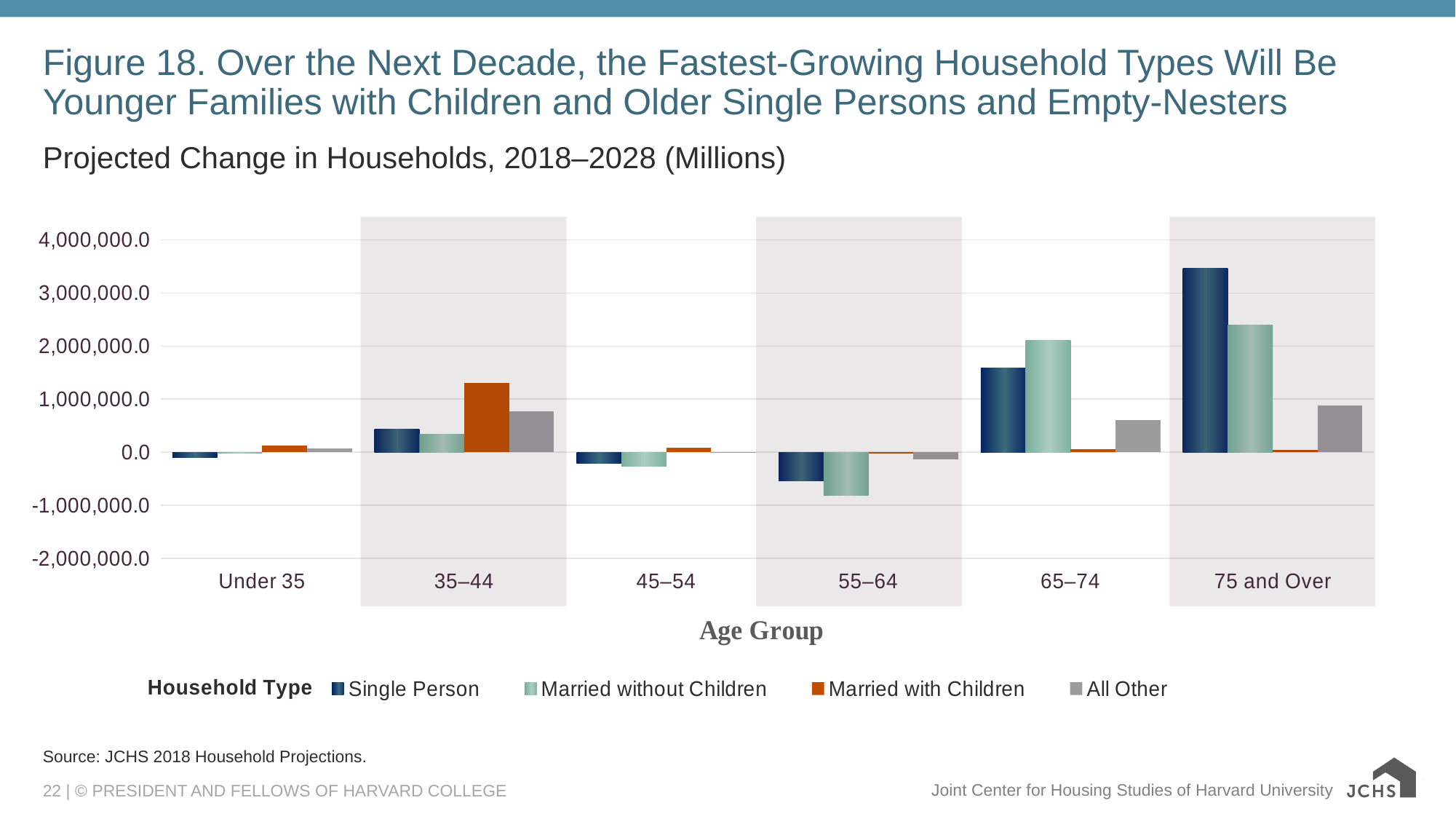
For the 65–74 age group, which is larger: Single Person or Married without Children? Married without Children How many age groups are shown on the x axis? 6 Is the All Other value for 35–44 greater or less than 1,000,000.0? less Which age group has the highest Married with Children bar? 35–44 Is the Single Person value for 75 and Over greater or less than 3,000,000.0? greater Which age group has the lowest Married without Children bar? 55–64 Which age group has the highest Single Person bar? 75 and Over What kind of chart is shown on the slide? bar chart How many household types does the legend list? 4 Is the Married with Children value for 35–44 greater or less than 1,000,000.0? greater For the 75 and Over age group, which is larger: Single Person or Married without Children? Single Person What is the title of the x axis? Age Group